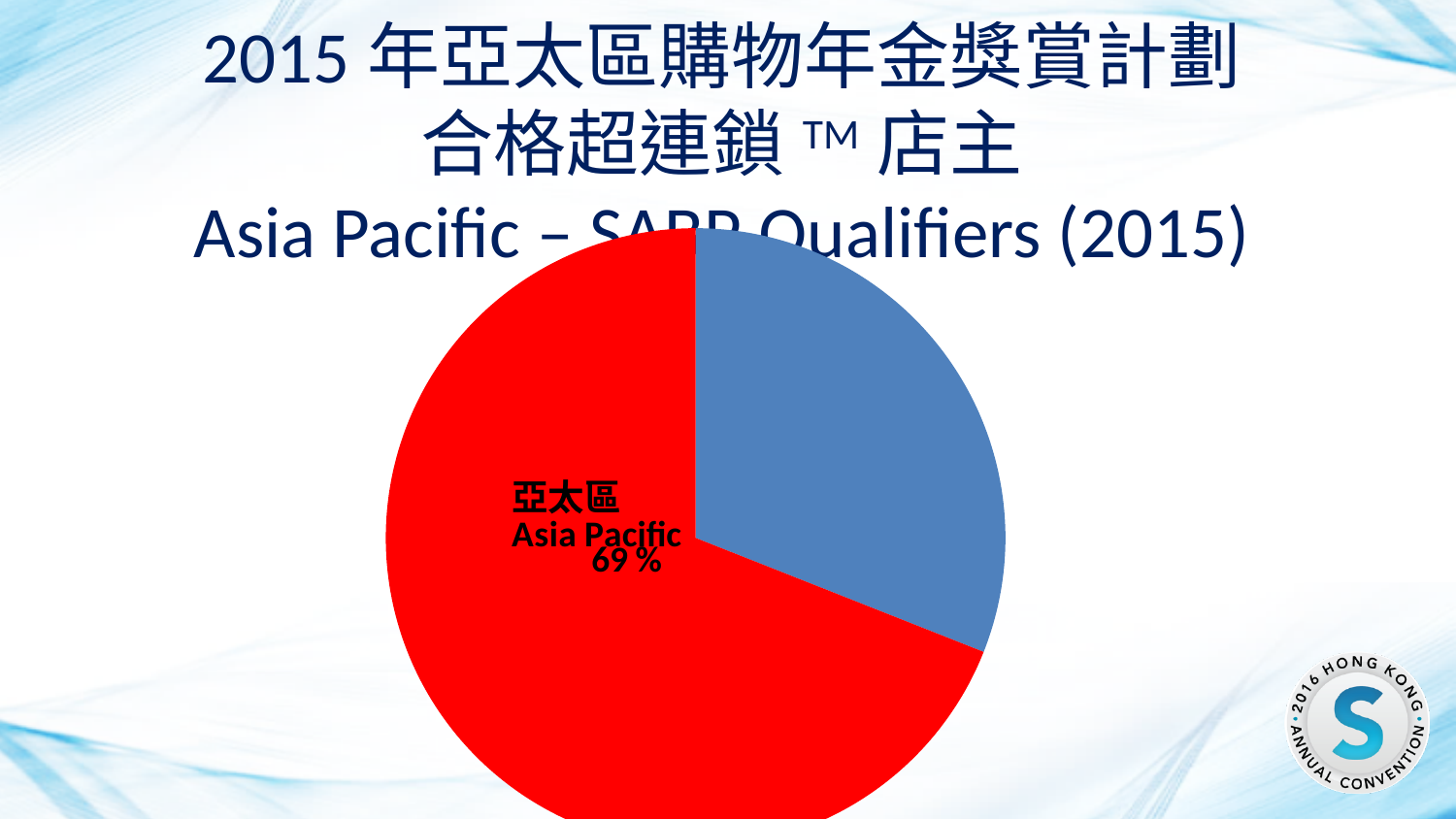
What kind of chart is shown on the slide? pie chart What value is printed on the Asia Pacific slice of the pie chart? 69 % Which slice is larger, the red slice or the blue slice? the red slice Which slice of the pie chart is the smallest? the blue slice Which slice of the pie chart is the largest? Asia Pacific (亞太區) What share of the pie does the Asia Pacific (亞太區) slice represent? 69 % How many slices of the pie chart have a data label printed on them? 1 Is the Asia Pacific share greater or less than 50%? greater What colour is the Asia Pacific slice in the pie chart? red How many slices does the pie chart have? 2